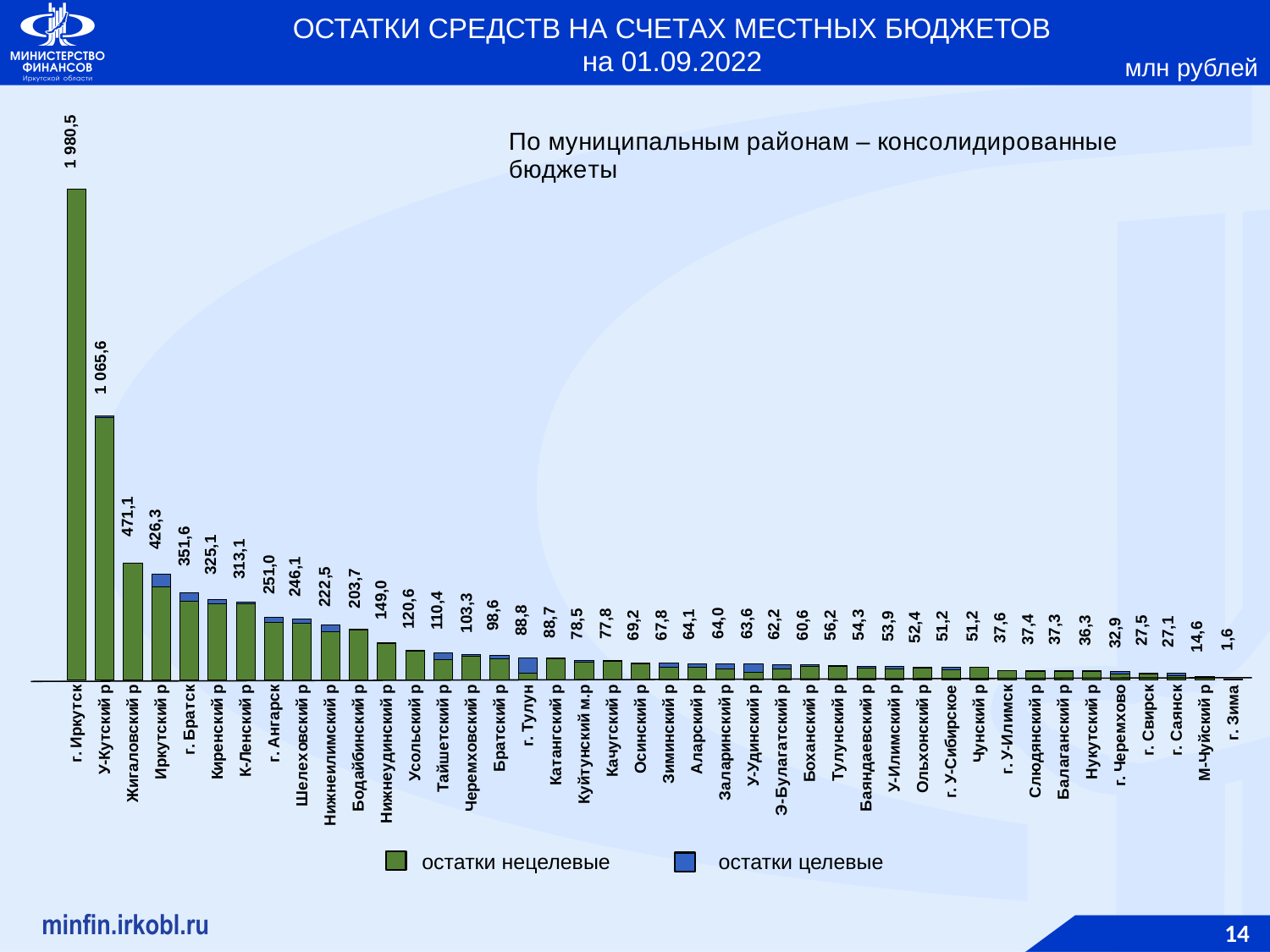
What is the total value shown for г. Иркутск? 1 980,5 How many series does the legend list? 2 What is the total value shown for Жигаловский р? 471,1 Which category has the lowest total value? г. Зима What is the difference between the totals for г. Иркутск and У-Кутский р? 914,9 Do the total values rise or fall from left to right along the x axis? fall What is the total value shown for г. Зима? 1,6 What is the total value shown for г. Ангарск? 251,0 Which category has the highest total value? г. Иркутск What kind of chart is shown on the slide? stacked bar chart How many categories are shown on the x axis? 42 Which has a larger total, г. Братск or Киренский р? г. Братск